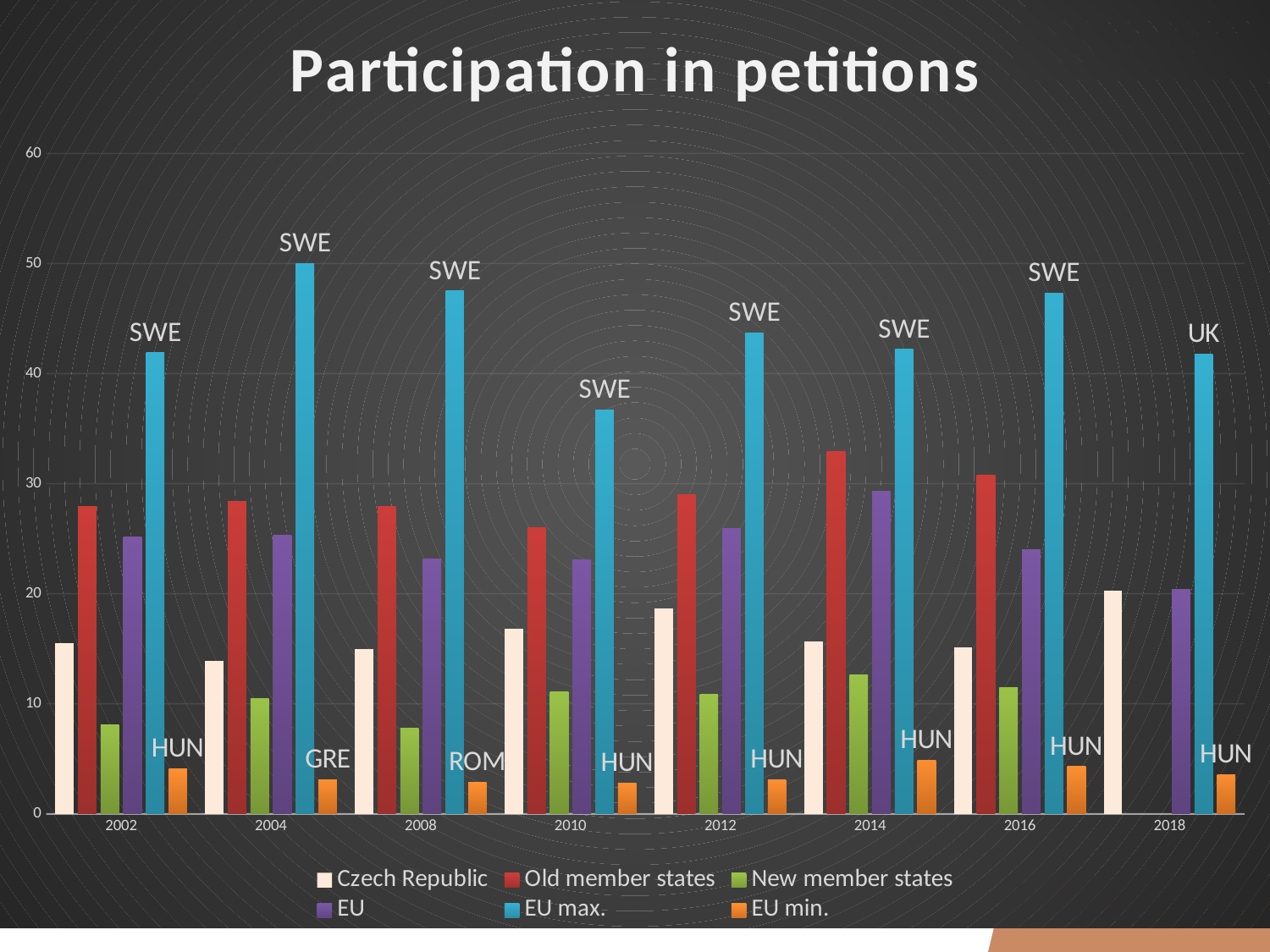
Is the Czech Republic value for 2012 greater or less than 20? less Is the EU max. value for 2004 greater or less than 40? greater What is the title of the chart? Participation in petitions Is the EU min. value for 2010 greater or less than 10? less Which country label is shown above the EU max. bar for 2018? UK Does the EU max. value rise or fall from 2008 to 2010? fall Which is larger, the Old member states value for 2014 or for 2002? 2014 How many years are shown on the x axis of the chart? 8 In which year is the EU max. value the lowest? 2010 What kind of chart is shown on the slide? bar chart In which year is the EU max. value the highest? 2004 How many series does the legend list? 6